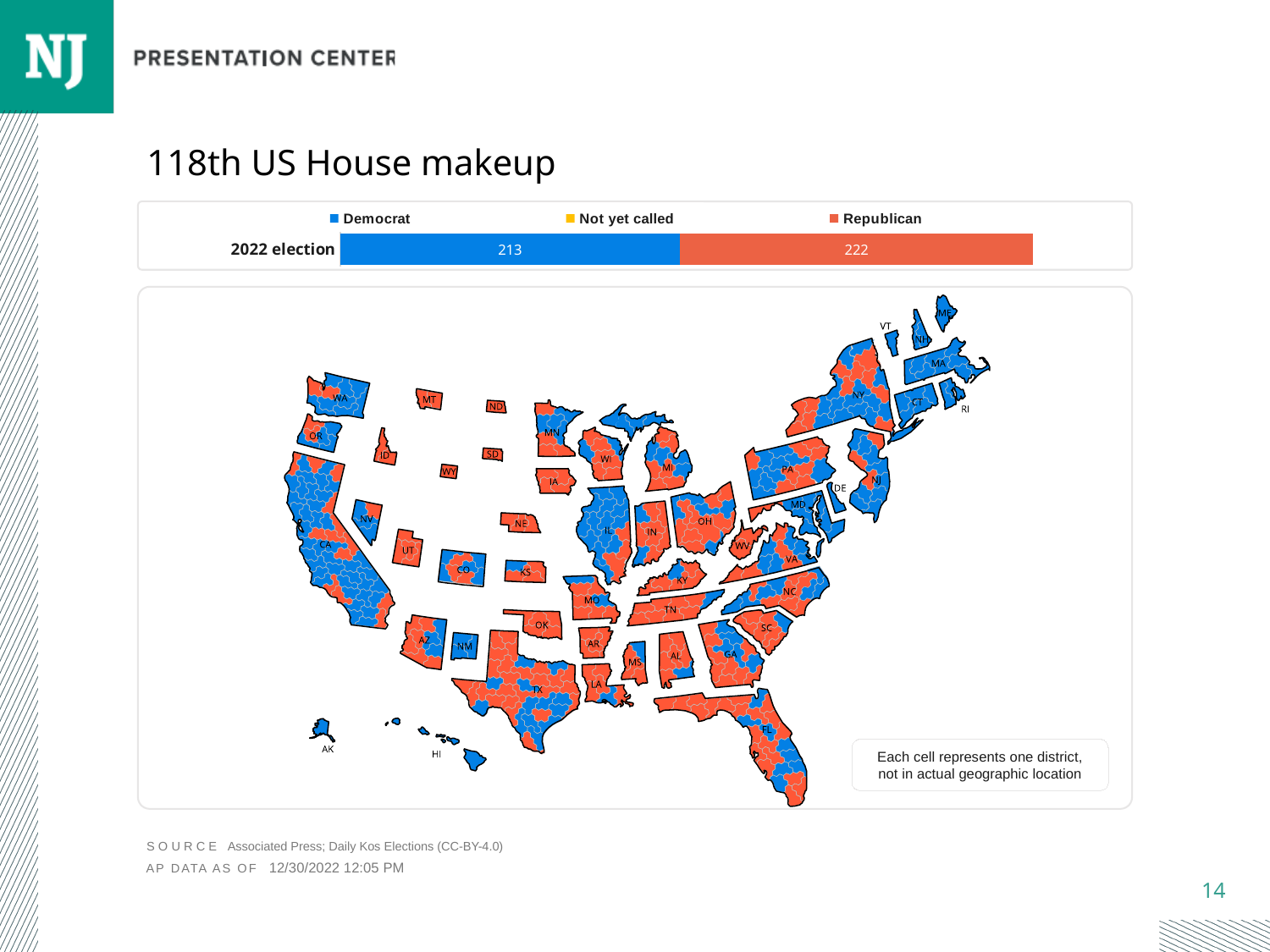
In the stacked bar chart, is the Democrat value for the 2022 election greater or less than 200? greater In the stacked bar chart, what is the value for Republican in the 2022 election? 222 What is the title of the slide's chart? 118th US House makeup How many categories (bars) are plotted in the stacked bar chart? 1 In the stacked bar chart, which series has the larger value for the 2022 election, Democrat or Republican? Republican In the stacked bar chart, what is the total of the 2022 election bar (Democrat plus Republican)? 435 In the stacked bar chart legend, which series is shown in yellow? Not yet called What kind of chart is shown at the top of the slide under the title? Stacked bar chart In the stacked bar chart, which series has the lowest value for the 2022 election among those with a visible segment? Democrat In the stacked bar chart, what is the difference between the Republican and Democrat values for the 2022 election? 9 How many series does the legend of the stacked bar chart list? 3 In the stacked bar chart, what is the value for Democrat in the 2022 election? 213